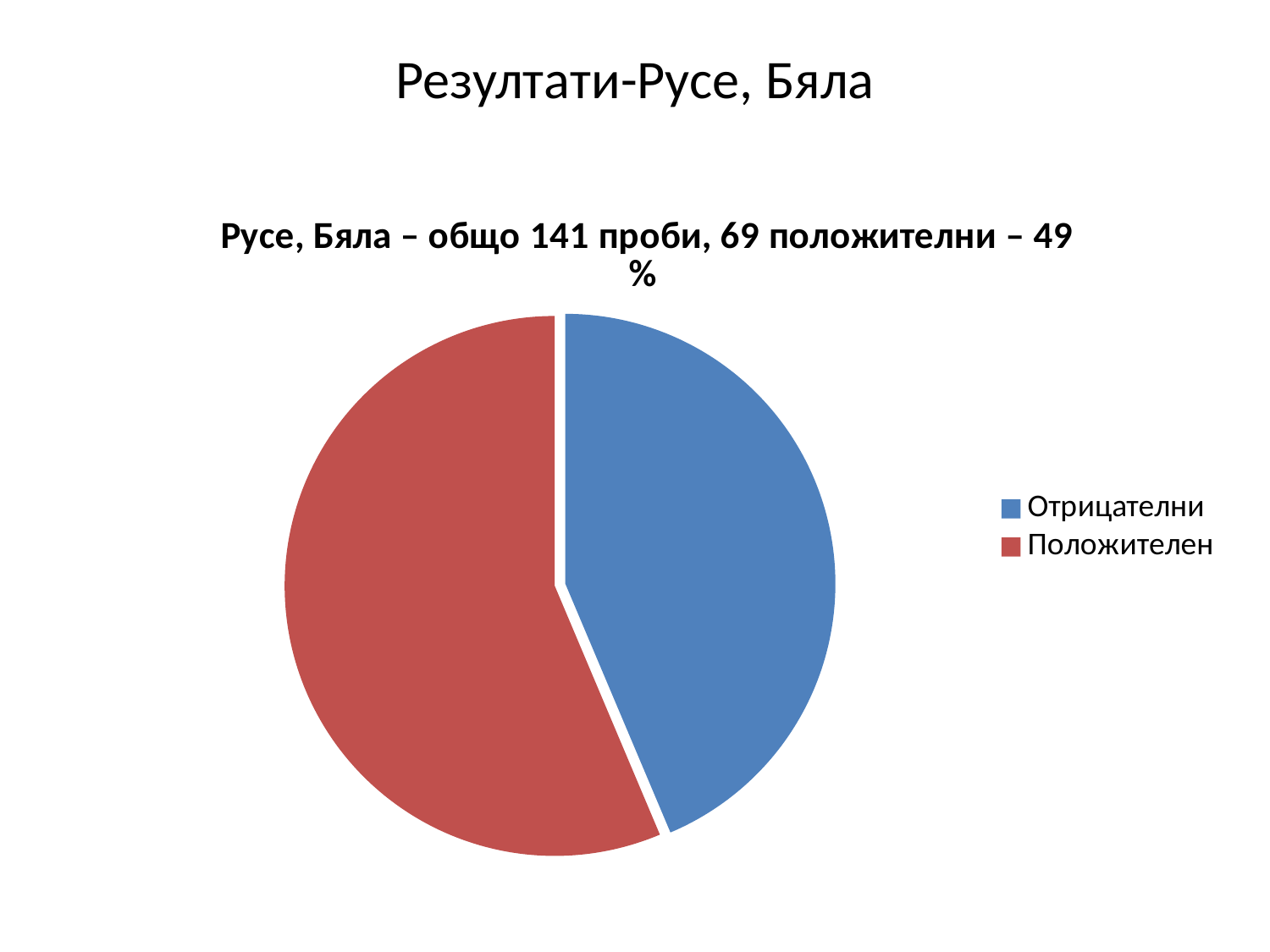
Using the numbers in the chart title, how many samples were not positive (141 total minus 69 positive)? 72 According to the chart title, what is the total number of samples (проби) for Русе, Бяла? 141 How many slices does the pie chart have? 2 According to the chart title, how many samples were positive (положителни)? 69 What kind of chart is shown on the slide? pie chart According to the chart title, what percentage of the samples were positive? 49 % What is the title of the pie chart? Русе, Бяла – общо 141 проби, 69 положителни – 49 % How many entries does the legend of the pie chart list? 2 Which colour represents Отрицателни in the pie chart? blue